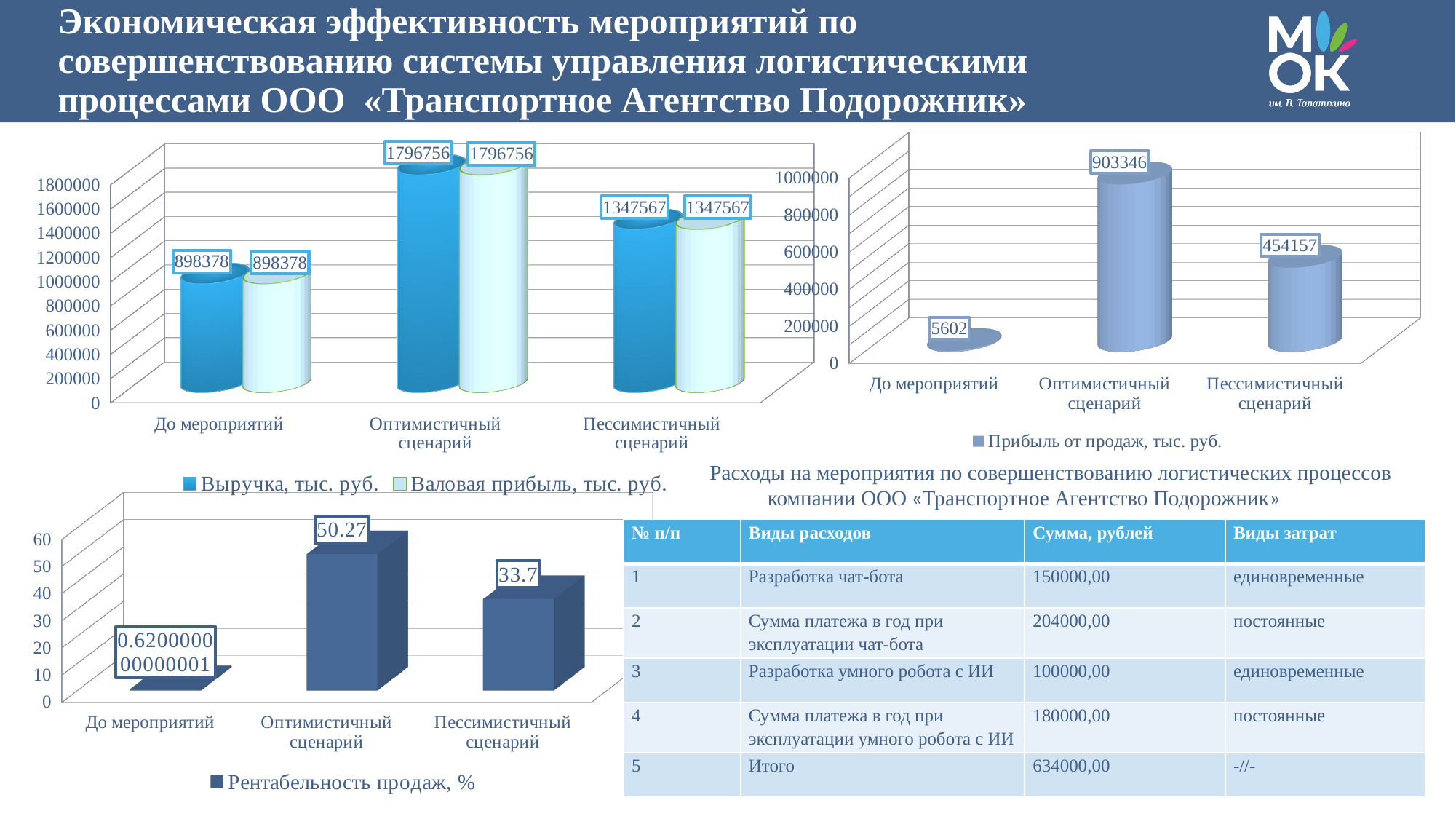
In the top-left chart, which has the larger Выручка, тыс. руб.: Оптимистичный сценарий or Пессимистичный сценарий? Оптимистичный сценарий What kind of chart is the bottom-left chart (Рентабельность продаж, %)? bar chart In the top-left chart, what is the difference in Выручка, тыс. руб. between Оптимистичный сценарий and До мероприятий? 898378 In the top-right chart (Прибыль от продаж, тыс. руб.), which category has the lowest value? До мероприятий In the top-left chart, what is the Выручка, тыс. руб. value for До мероприятий? 898378 How many series does the legend of the top-left chart list? 2 In the bottom-left chart (Рентабельность продаж, %), what is the difference between Оптимистичный сценарий and Пессимистичный сценарий? 16.57 In the top-right chart (Прибыль от продаж, тыс. руб.), what is the difference between Оптимистичный сценарий and Пессимистичный сценарий? 449189 In the top-right chart (Прибыль от продаж, тыс. руб.), which category has the highest value? Оптимистичный сценарий How many categories are shown on the x axis of the top-left chart? 3 In the bottom-left chart (Рентабельность продаж, %), what is the value for Пессимистичный сценарий? 33.7 In the top-right chart (Прибыль от продаж, тыс. руб.), what is the value for Оптимистичный сценарий? 903346